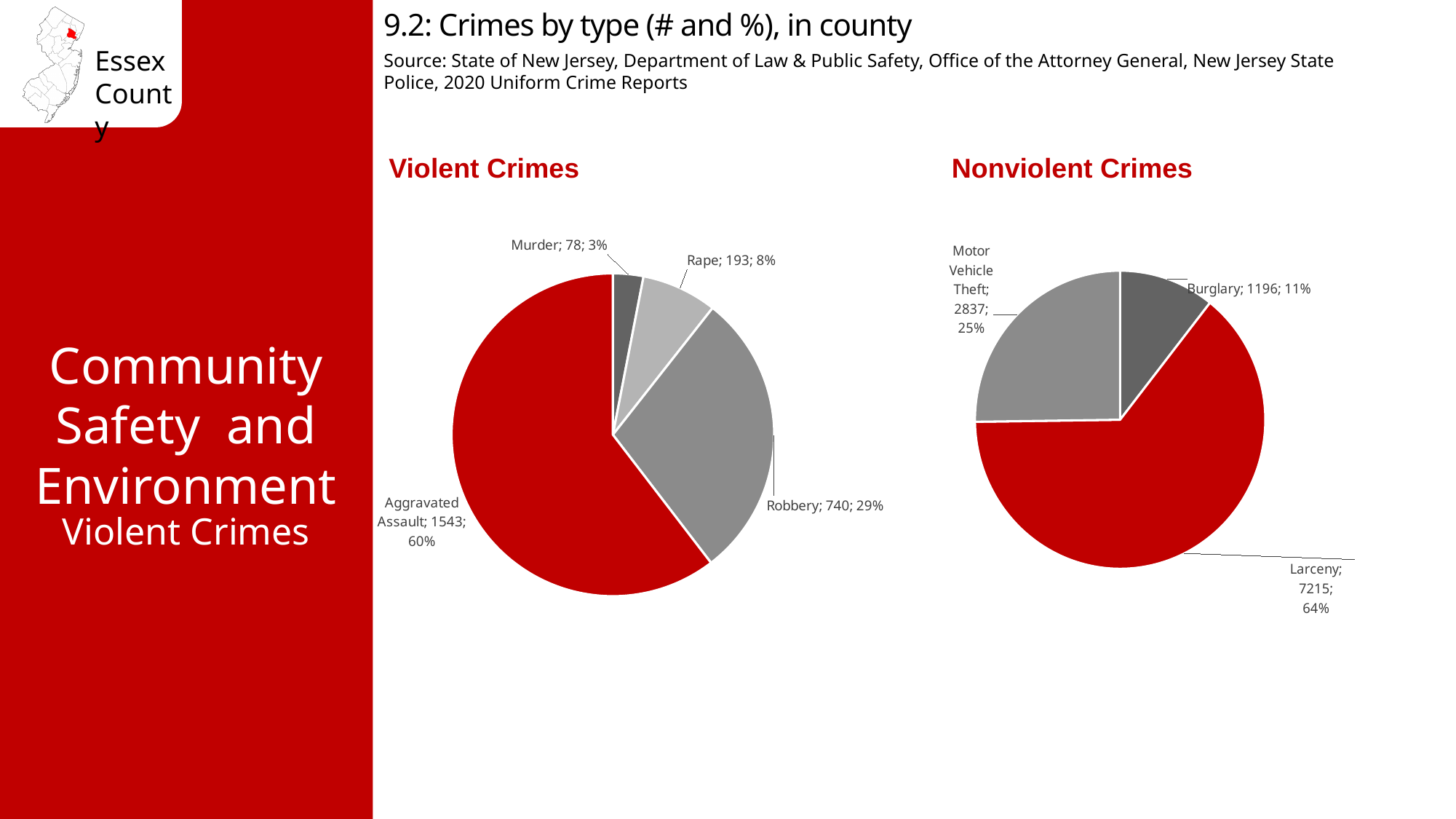
What type of chart is used for the Violent Crimes chart? Pie chart In the Violent Crimes chart, how many aggravated assaults are shown? 1543 In the Violent Crimes chart, what is the difference between the number of robberies and the number of rapes? 547 In the Violent Crimes chart, how many crime types are shown? 4 In the Violent Crimes chart, what percentage of violent crimes is robbery? 29% In the Nonviolent Crimes chart, what is the difference between the number of motor vehicle thefts and burglaries? 1641 In the Nonviolent Crimes chart, how many larcenies are shown? 7215 In the Violent Crimes chart, which crime type has the smallest slice? Murder In the Nonviolent Crimes chart, what percentage of nonviolent crimes is motor vehicle theft? 25% In the Nonviolent Crimes chart, which is larger, motor vehicle theft or burglary? Motor Vehicle Theft In the Nonviolent Crimes chart, which crime type has the smallest slice? Burglary In the Violent Crimes chart, which crime type has the largest slice? Aggravated Assault